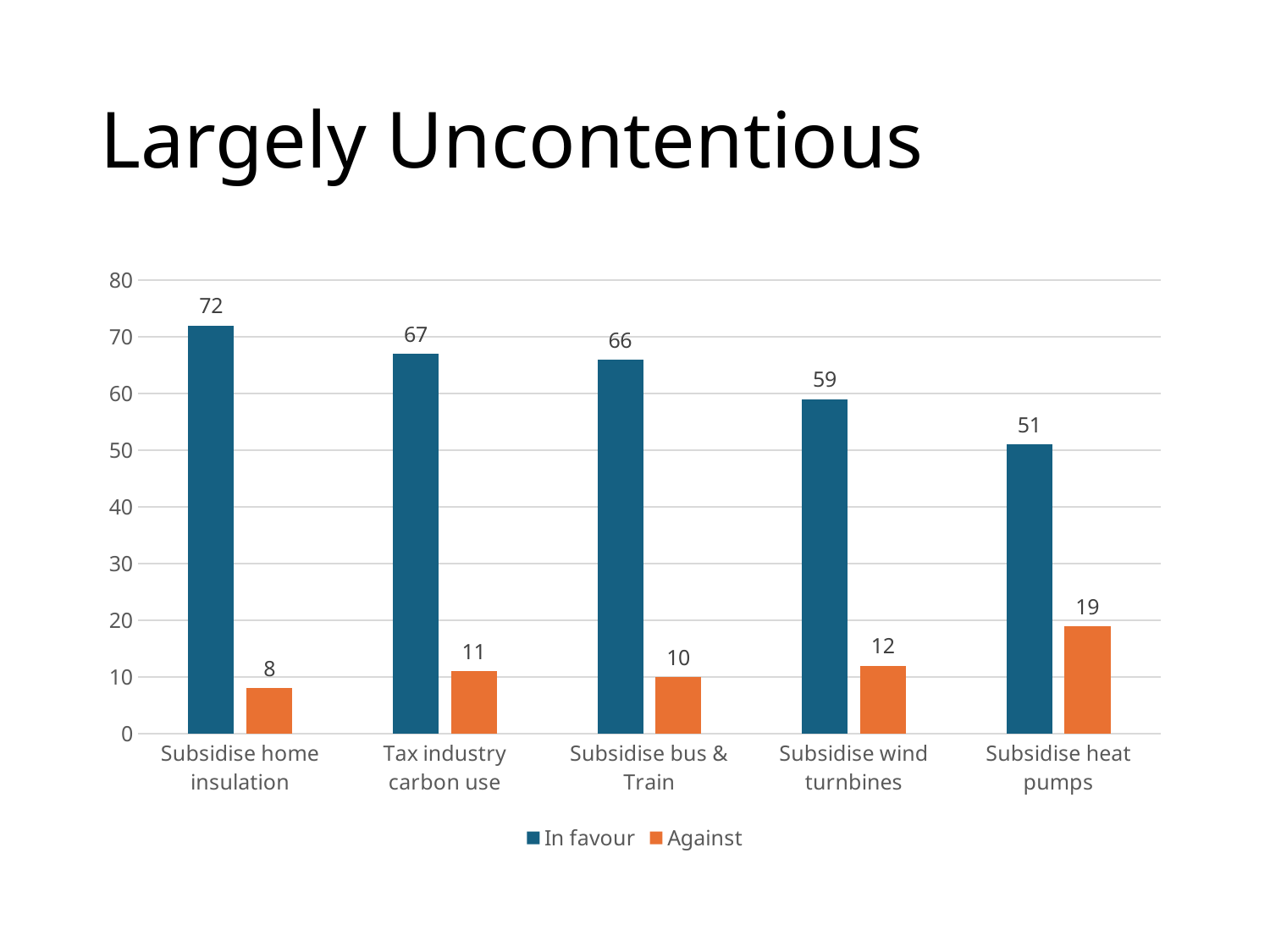
Which category has the lowest 'Against' value? Subsidise home insulation What is the 'Against' value for Tax industry carbon use? 11 How many series does the legend list? 2 Which is larger: the 'In favour' value for Tax industry carbon use or for Subsidise bus & Train? Tax industry carbon use Is the 'In favour' value for Subsidise heat pumps greater or less than 60? less How many categories are shown on the x axis? 5 Which category has the highest 'In favour' value? Subsidise home insulation What is the difference between the 'In favour' and 'Against' values for Subsidise wind turnbines? 47 Which category has the lowest 'In favour' value? Subsidise heat pumps What kind of chart is shown on the slide? bar chart What is the 'Against' value for Subsidise heat pumps? 19 What is the 'In favour' value for Subsidise home insulation? 72